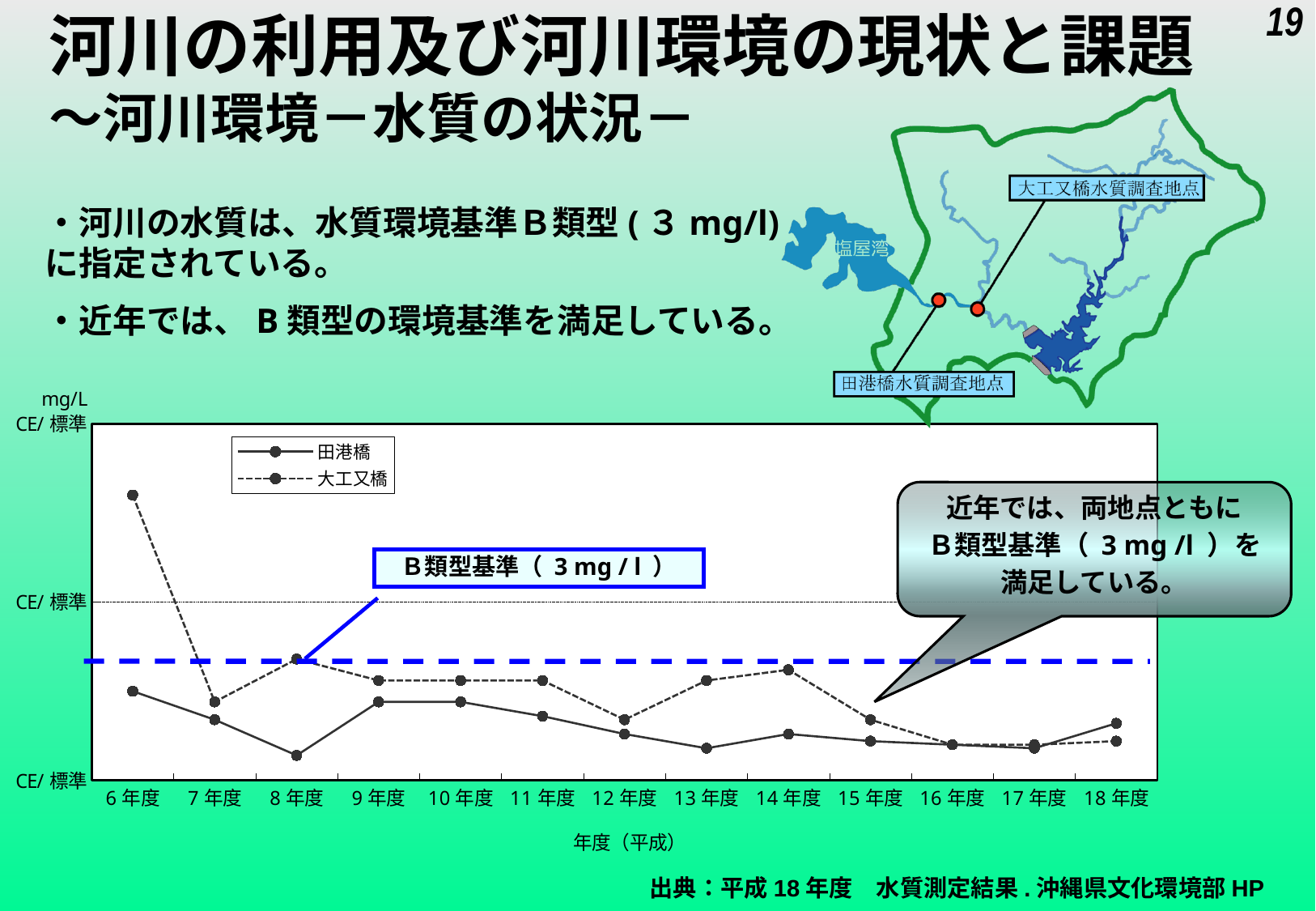
How many series does the chart legend list? 2 In 14年度, which series has the larger value, 田港橋 or 大工又橋? 大工又橋 Does the 大工又橋 series rise or fall from 6年度 to 7年度? fall How many fiscal years (年度) are plotted along the x axis of the chart? 13 In which fiscal year does the 田港橋 series reach its lowest value? 8年度 What is the label of the x axis of the chart? 年度（平成） Is the value for 田港橋 in 6年度 greater or less than the B類型基準 of 3 mg/l? less In 6年度, which series has the larger value, 田港橋 or 大工又橋? 大工又橋 What kind of chart is shown on the slide? line chart Is the value for 大工又橋 in 6年度 greater or less than the B類型基準 of 3 mg/l? greater Which series are listed in the chart legend? 田港橋 and 大工又橋 In which fiscal year does the 大工又橋 series reach its highest value? 6年度